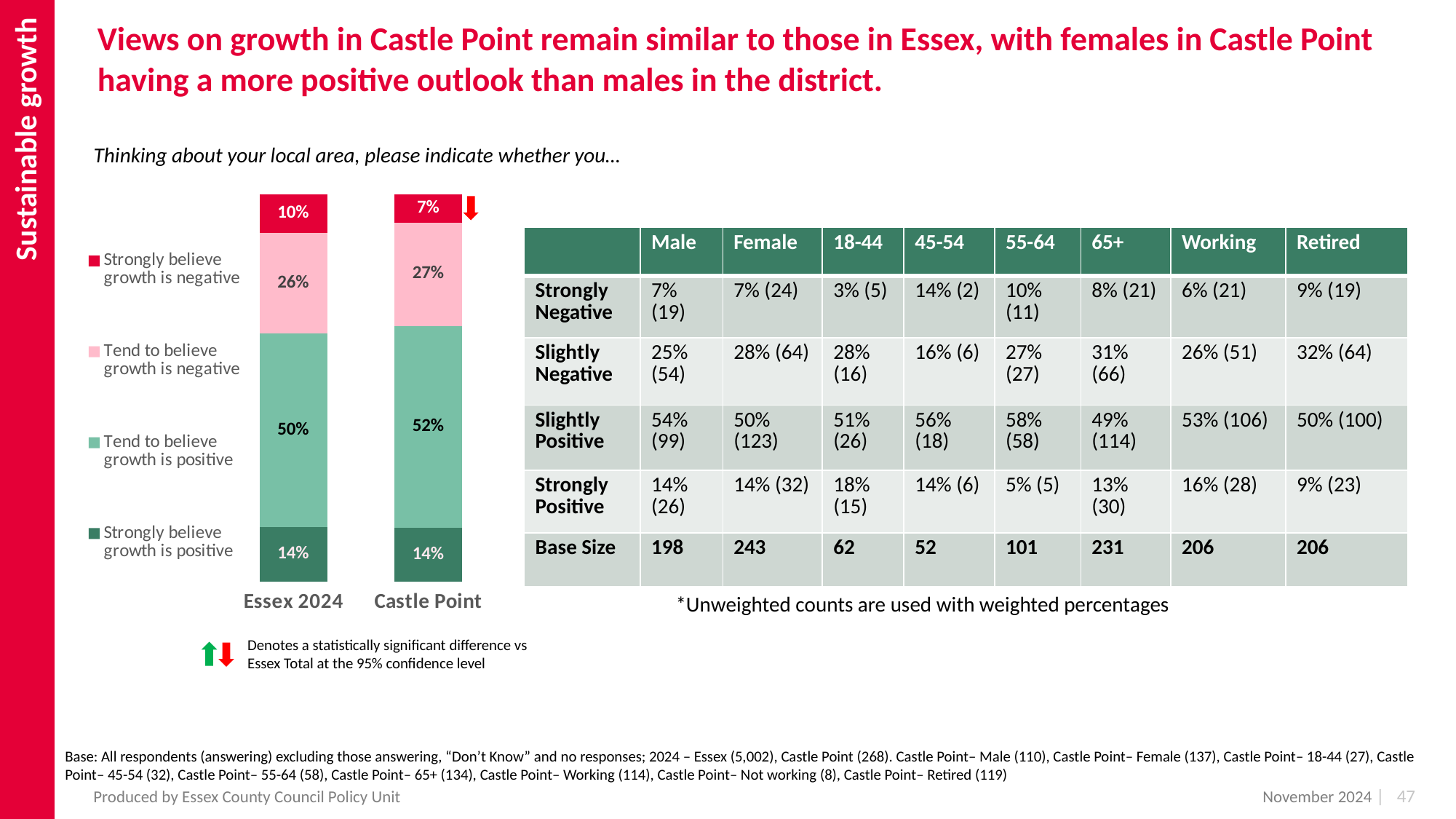
Which segment is the smallest in the Castle Point bar? Strongly believe growth is negative What percentage of Castle Point respondents strongly believe growth is negative? 7% Which has a higher 'Strongly believe growth is negative' value, Essex 2024 or Castle Point? Essex 2024 What percentage of Castle Point respondents tend to believe growth is positive? 52% What percentage of Essex 2024 respondents strongly believe growth is negative? 10% What is the difference between the 'Tend to believe growth is positive' values for Castle Point and Essex 2024? 2% What kind of chart is shown on the slide? Stacked bar chart What percentage of Essex 2024 respondents tend to believe growth is negative? 26% Which segment is the largest in the Castle Point bar? Tend to believe growth is positive How many series does the chart's legend list? 4 What colour represents 'Strongly believe growth is positive' in the chart? Dark green How many bars (categories) does the chart show? 2